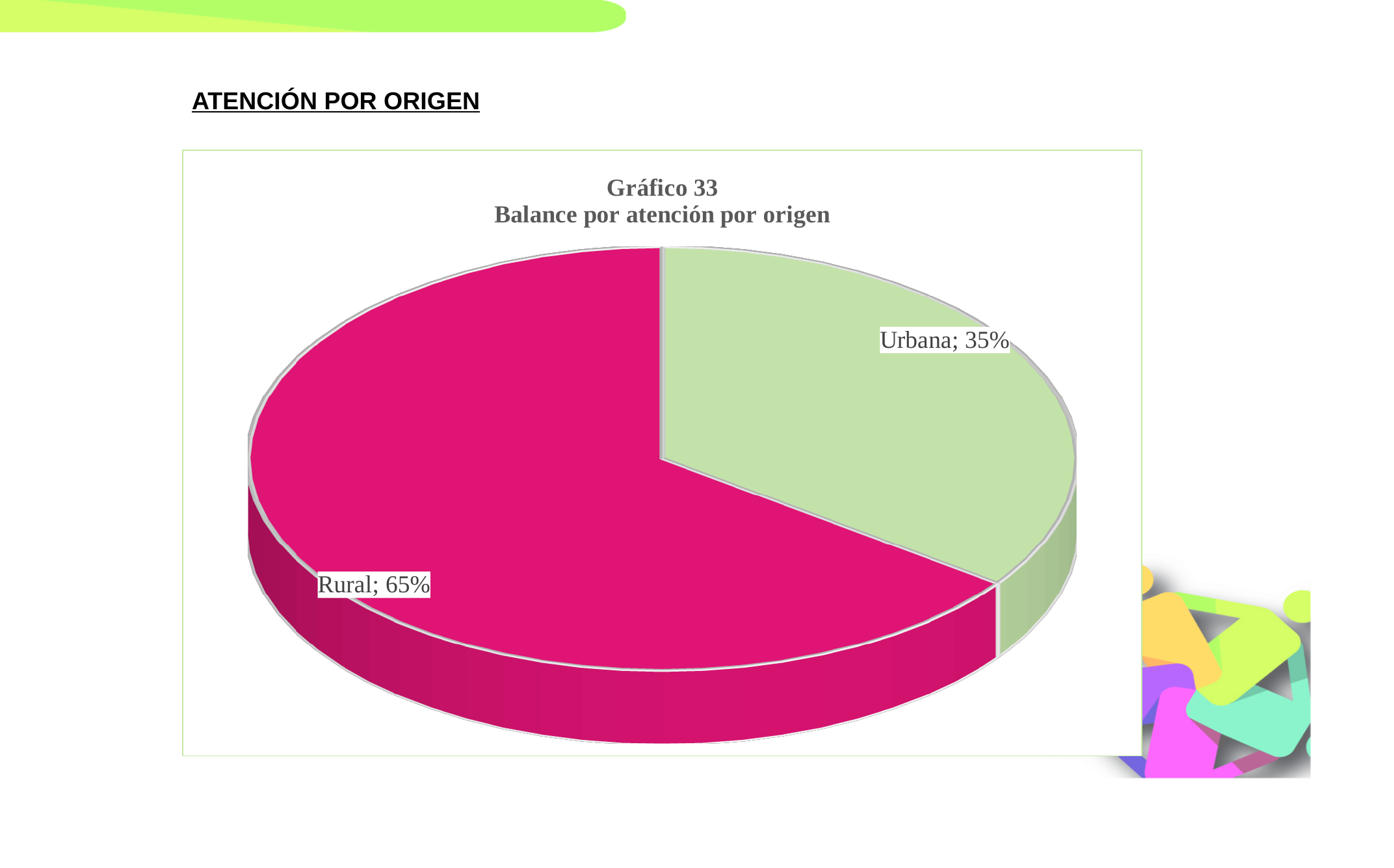
How many slices does the pie chart have? 2 What is the title of the chart? Gráfico 33 Balance por atención por origen What share of the pie does the Rural slice represent? 65% What is the total of the Rural and Urbana slices? 100% Is the value for Urbana greater or less than 50%? less Which slice is larger, Rural or Urbana? Rural What share of the pie does the Urbana slice represent? 35% What kind of chart is shown on the slide? Pie chart Which category has the smallest slice of the pie? Urbana What is the difference in percentage points between the Rural and Urbana slices? 30 percentage points Which category has the largest slice of the pie? Rural What colour is the Rural slice? Magenta (pink)